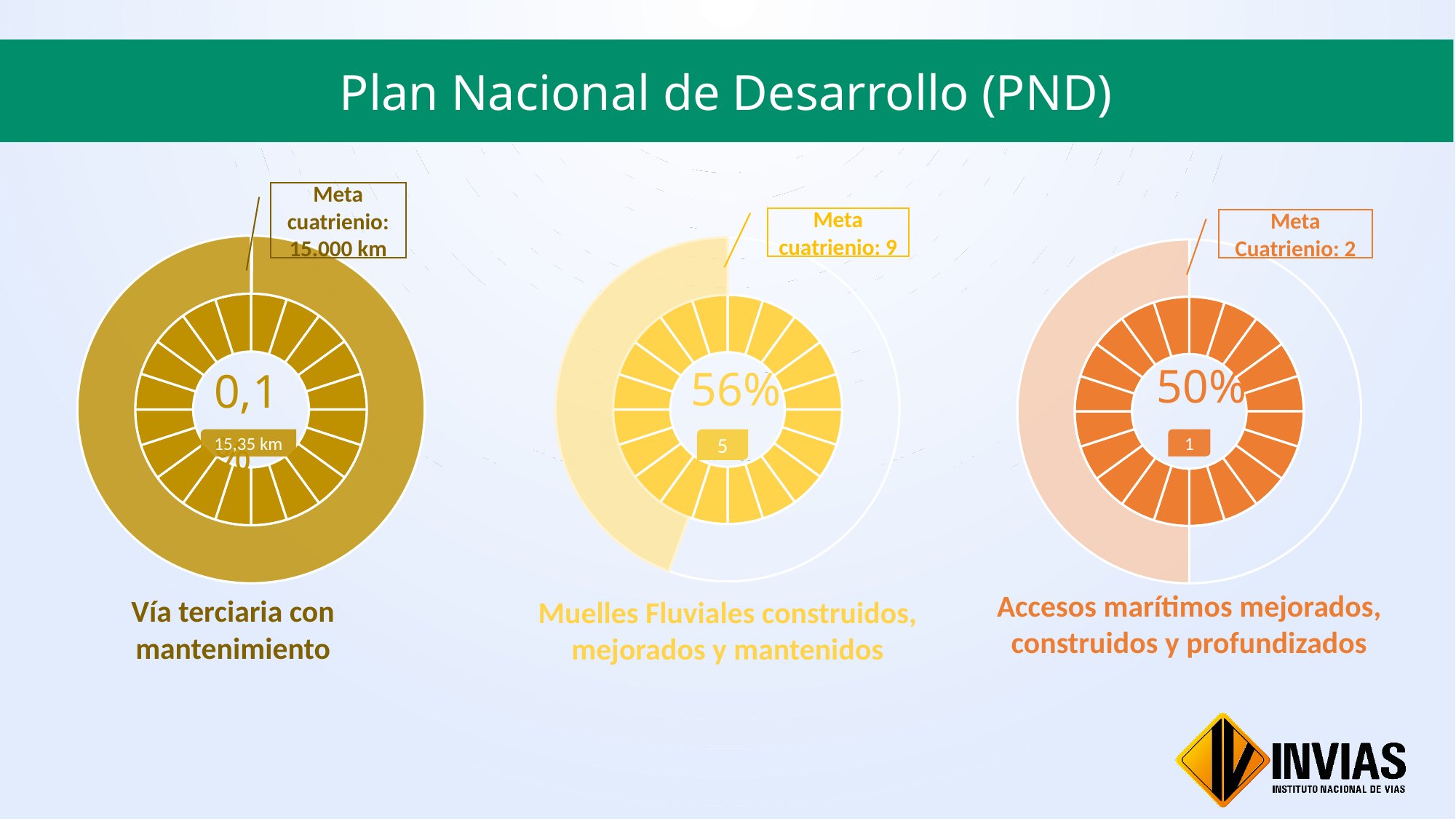
What is the 'Meta Cuatrienio' target shown for the 'Accesos marítimos mejorados, construidos y profundizados' chart? 2 Which chart shows a higher percentage, 'Muelles Fluviales construidos, mejorados y mantenidos' or 'Accesos marítimos mejorados, construidos y profundizados'? Muelles Fluviales construidos, mejorados y mantenidos What is the 'Meta cuatrienio' target shown for the 'Vía terciaria con mantenimiento' chart? 15.000 km What number is shown in the small label inside the 'Accesos marítimos mejorados, construidos y profundizados' chart? 1 What km value is shown in the small label inside the 'Vía terciaria con mantenimiento' chart? 15,35 km What is the 'Meta cuatrienio' target shown for the 'Muelles Fluviales construidos, mejorados y mantenidos' chart? 9 How many charts are shown on the slide? 3 What percentage is shown in the centre of the 'Muelles Fluviales construidos, mejorados y mantenidos' chart? 56% What kind of chart is used for 'Muelles Fluviales construidos, mejorados y mantenidos'? Donut chart What is the title of the slide? Plan Nacional de Desarrollo (PND) What number is shown in the small label inside the 'Muelles Fluviales construidos, mejorados y mantenidos' chart? 5 What percentage is shown in the centre of the 'Accesos marítimos mejorados, construidos y profundizados' chart? 50%